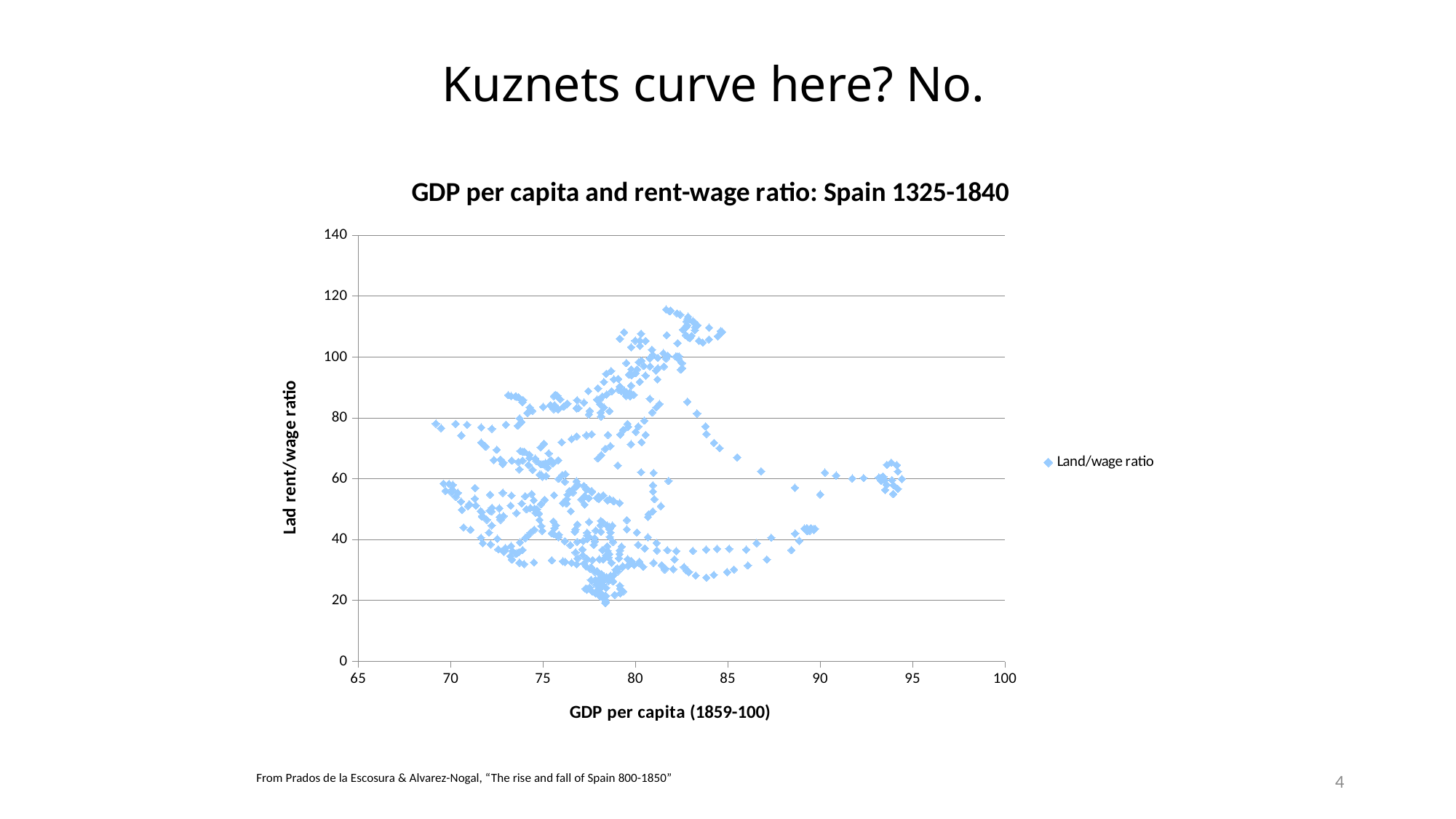
Is the largest GDP per capita value among the plotted points greater or less than 90? greater Is the highest plotted rent/wage ratio value greater or less than 100? greater Are there any plotted points with a rent/wage ratio above 140? No What kind of chart is shown on the slide? Scatter plot What is the title of the chart? GDP per capita and rent-wage ratio: Spain 1325-1840 How many series does the legend list? 1 What is the name of the series shown in the legend? Land/wage ratio